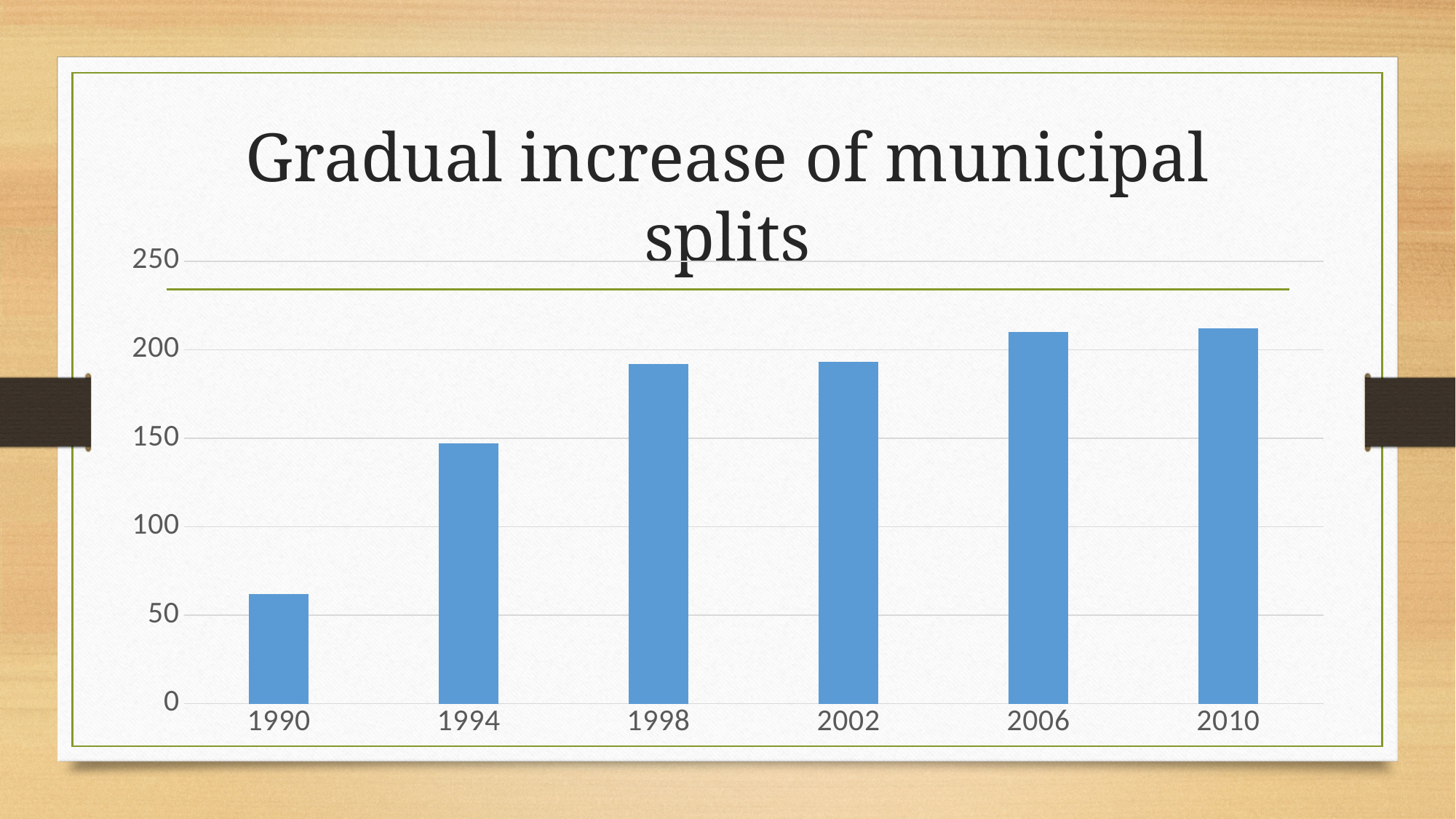
Is the value for 2006 greater or less than 200? greater Is the value for 1994 greater or less than 100? greater What kind of chart is shown on the slide? bar chart Which is larger, the value for 1990 or the value for 2006? 2006 Do the values generally rise or fall from 1990 to 2010? rise Is the value for 1990 greater or less than 100? less What is the title of the chart on the slide? Gradual increase of municipal splits How many years are shown on the x axis of the chart? 6 Which is larger, the value for 1994 or the value for 1998? 1998 Which year has the lowest value in the chart? 1990